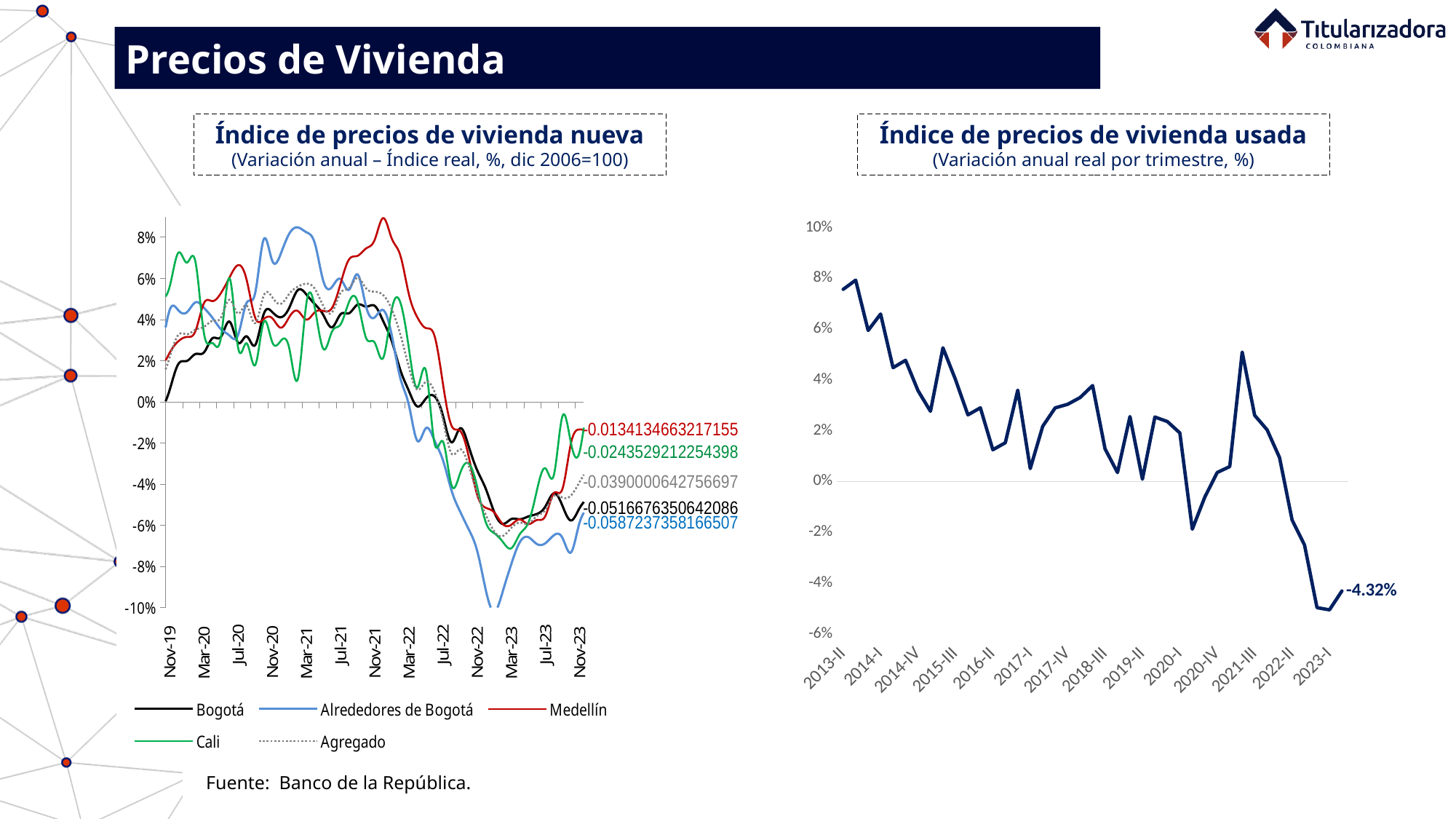
In the 'Índice de precios de vivienda nueva' chart, what is the final labelled value for Bogotá? -0.0516676350642086 How many series does the legend of the 'Índice de precios de vivienda nueva' chart list? 5 In the 'Índice de precios de vivienda nueva' chart, which series has the highest value at the end of the period (Nov-23)? Medellín What kind of chart is the 'Índice de precios de vivienda nueva' chart on the left? line chart In the 'Índice de precios de vivienda nueva' chart, is the lowest point of the Alrededores de Bogotá line (around Nov-22) greater or less than -8%? less In the 'Índice de precios de vivienda nueva' chart, what is the final labelled value for Medellín? -0.0134134663217155 In the 'Índice de precios de vivienda usada' chart on the right, what is the labelled value at the last data point? -4.32% In the 'Índice de precios de vivienda nueva' chart, what is the final labelled value for Alrededores de Bogotá? -0.0587237358166507 In the 'Índice de precios de vivienda nueva' chart, which series has the lowest value at the end of the period (Nov-23)? Alrededores de Bogotá In the 'Índice de precios de vivienda usada' chart, is the value for 2013-II greater or less than 6%? greater In the 'Índice de precios de vivienda nueva' chart, is the final value for Cali or for Bogotá larger? Cali In the 'Índice de precios de vivienda usada' chart, do the values generally rise or fall from 2013-II to 2023-I? fall